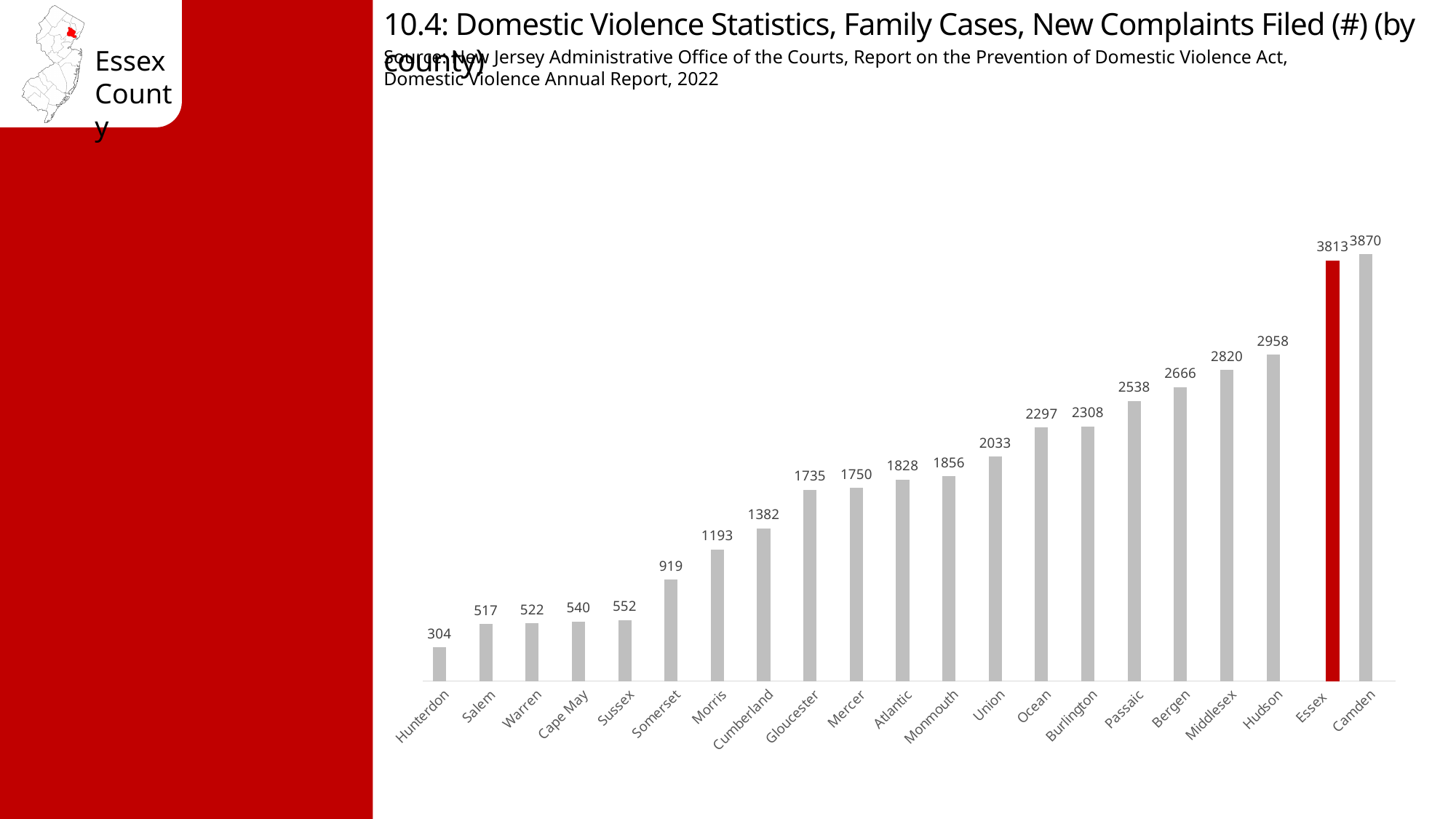
Which has a higher value, Somerset or Sussex? Somerset Which county's bar is highlighted in red? Essex Which county has the lowest number of new complaints filed? Hunterdon What is the value shown for Morris? 1193 What is the number of new domestic violence family case complaints filed for Essex? 3813 What is the value shown for Union? 2033 Which has a higher value, Ocean or Burlington? Burlington Which county has the highest number of new complaints filed? Camden What is the difference between the values for Camden and Essex? 57 What kind of chart is shown on the slide? Bar chart What is the difference between the values for Hudson and Middlesex? 138 How many counties are shown in the chart? 21